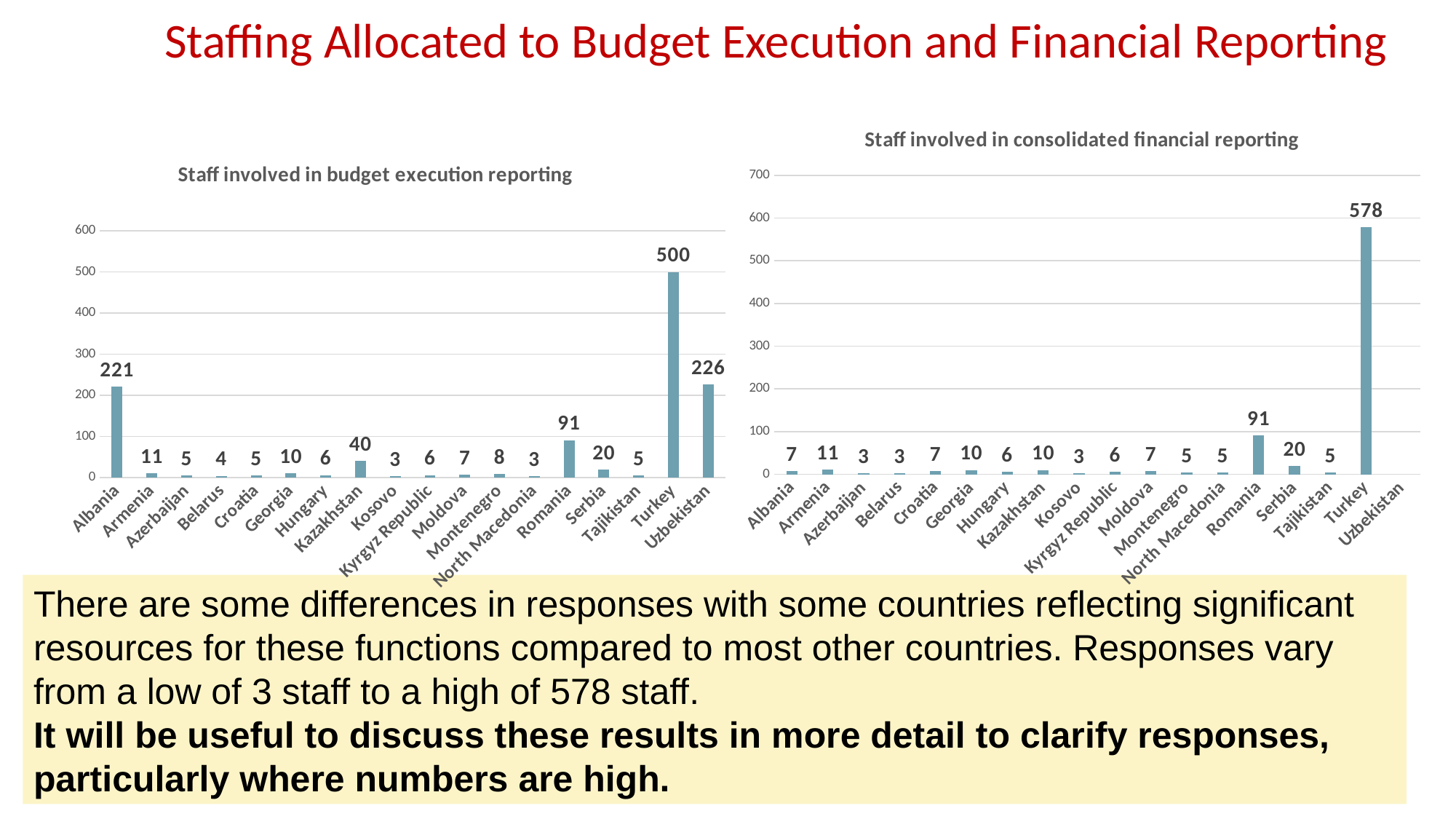
What type of chart is the 'Staff involved in consolidated financial reporting' chart? bar chart In the 'Staff involved in budget execution reporting' chart, what is the difference between the values for Uzbekistan and Albania? 5 In the 'Staff involved in consolidated financial reporting' chart, what is the value for Romania? 91 In the 'Staff involved in budget execution reporting' chart, which is larger, the value for Romania or the value for Kazakhstan? Romania How many countries are listed on the x axis of the 'Staff involved in budget execution reporting' chart? 18 In the 'Staff involved in consolidated financial reporting' chart, which country has the highest value? Turkey In the 'Staff involved in budget execution reporting' chart, what is the value for Turkey? 500 In the 'Staff involved in consolidated financial reporting' chart, what is the value for Turkey? 578 In the 'Staff involved in budget execution reporting' chart, what is the value for Kazakhstan? 40 In the 'Staff involved in consolidated financial reporting' chart, is the value for Turkey greater or less than 500? greater In the 'Staff involved in budget execution reporting' chart, which country has the highest value? Turkey In the 'Staff involved in budget execution reporting' chart, what is the value for Uzbekistan? 226